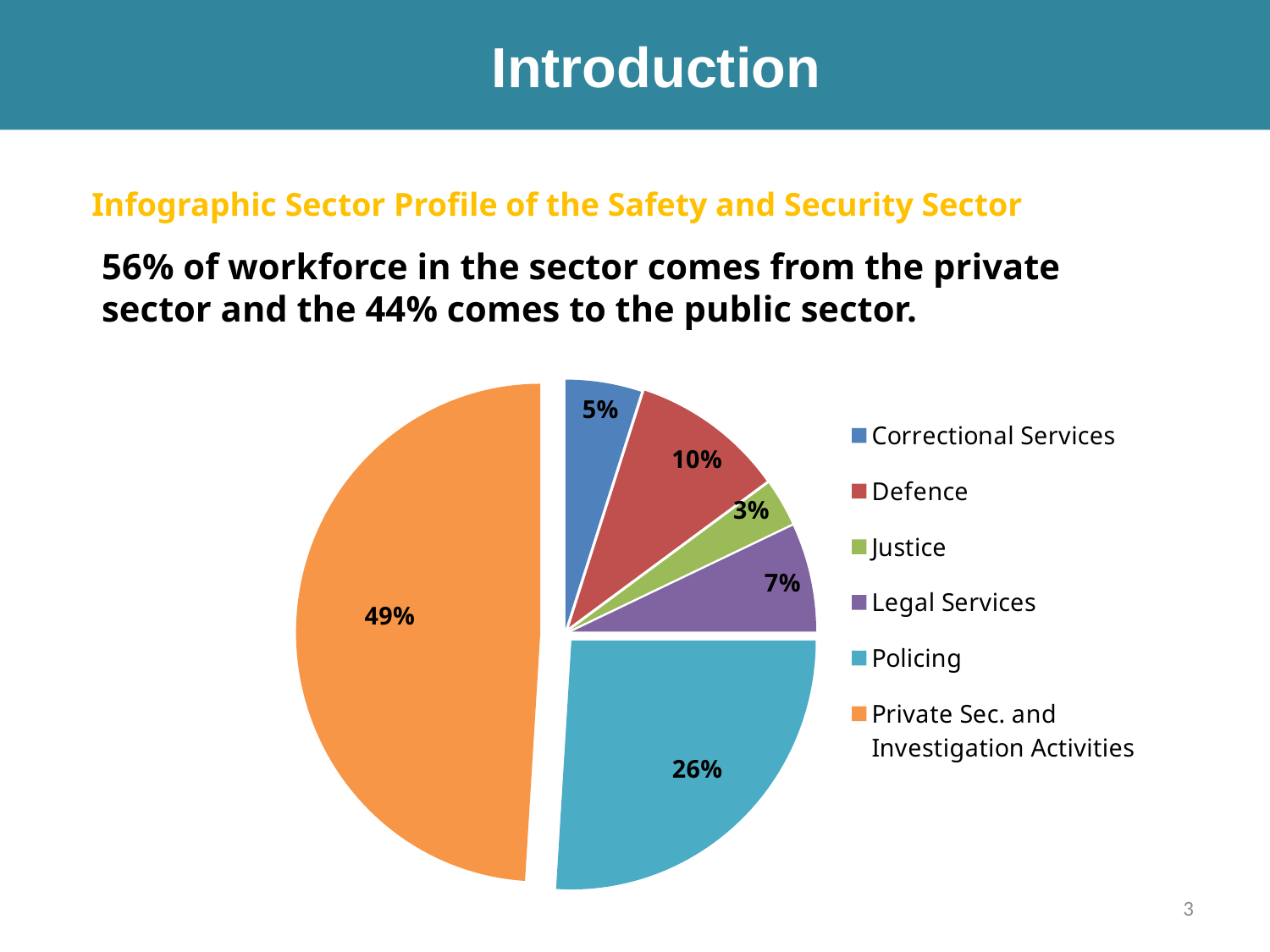
Which colour represents Policing in the pie chart? Light blue What share of the pie does Policing account for? 26% Which category has the largest slice of the pie? Private Sec. and Investigation Activities Which is larger, the share for Legal Services or the share for Correctional Services? Legal Services What is the value shown for Correctional Services? 5% What kind of chart is shown on the slide? Pie chart What is the difference between the Policing share and the Defence share? 16% How many categories does the pie chart show? 6 What is the value shown for Defence? 10% What is the combined share of Correctional Services and Defence? 15% Which category has the smallest slice of the pie? Justice What is the value shown for Legal Services? 7%